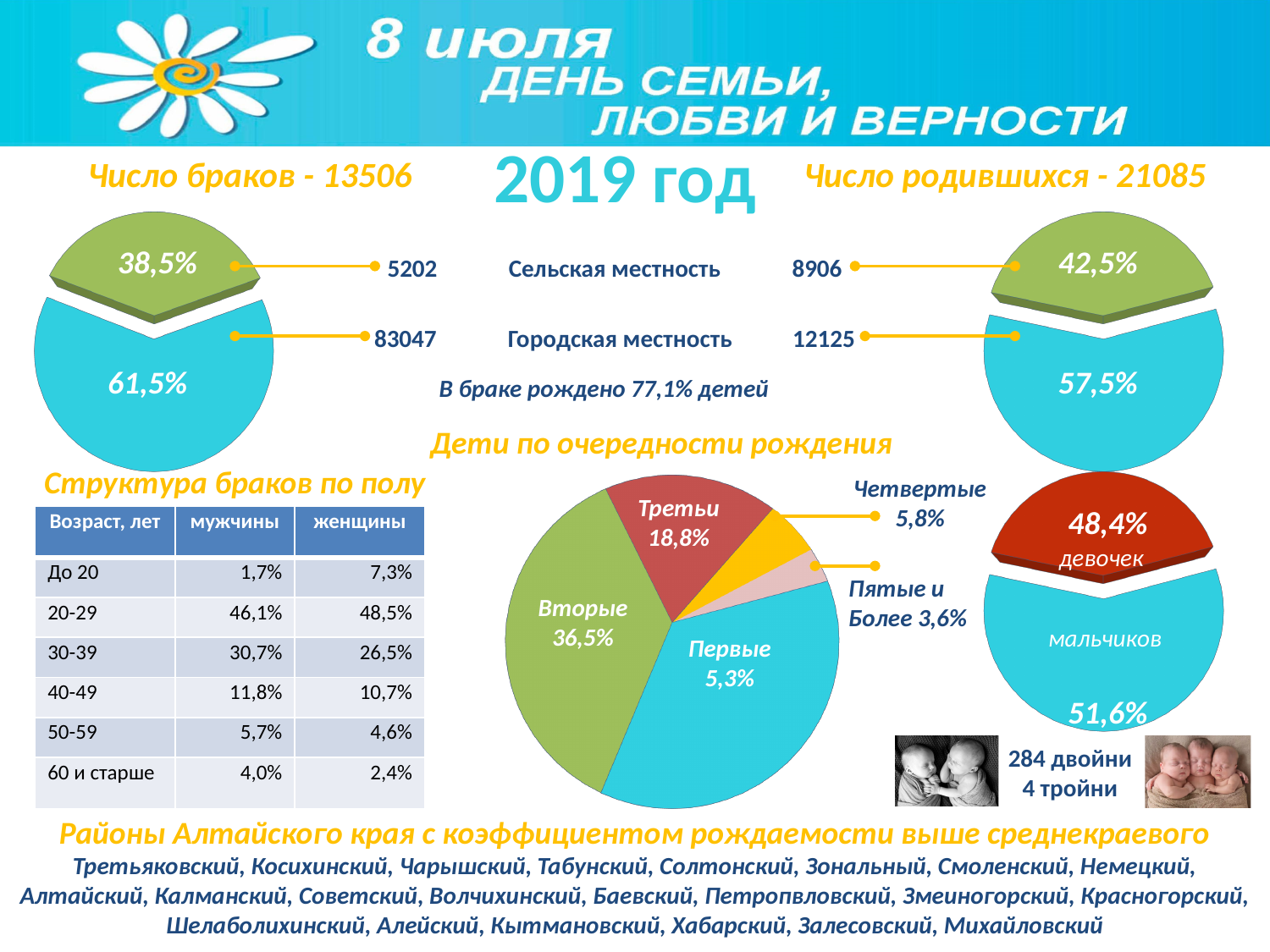
In the bottom-right pie chart showing births by sex, what percentage is shown for девочек (girls)? 48,4% In the pie chart titled "Число родившихся - 21085", what percentage is shown for the rural area (Сельская местность) slice? 42,5% In the pie chart titled "Число родившихся - 21085", which slice is larger: Сельская местность or Городская местность? Городская местность In the pie chart titled "Дети по очередности рождения", what percentage is shown for Третьи? 18,8% In the pie chart titled "Дети по очередности рождения", how many slices does the pie have? 5 In the pie chart titled "Число браков - 13506", what percentage is shown for the urban area (Городская местность) slice? 61,5% In the pie chart titled "Число родившихся - 21085", what percentage is shown for the urban area (Городская местность) slice? 57,5% In the pie chart titled "Число браков - 13506", what percentage is shown for the rural area (Сельская местность) slice? 38,5% In the pie chart titled "Число браков - 13506", what is the difference in percentage points between the urban and rural slices? 23 percentage points In the pie chart titled "Дети по очередности рождения", what percentage is shown for Вторые? 36,5% In the pie chart titled "Дети по очередности рождения", what percentage is shown for Четвертые? 5,8% In the bottom-right pie chart showing births by sex, which slice is larger: девочек or мальчиков? мальчиков